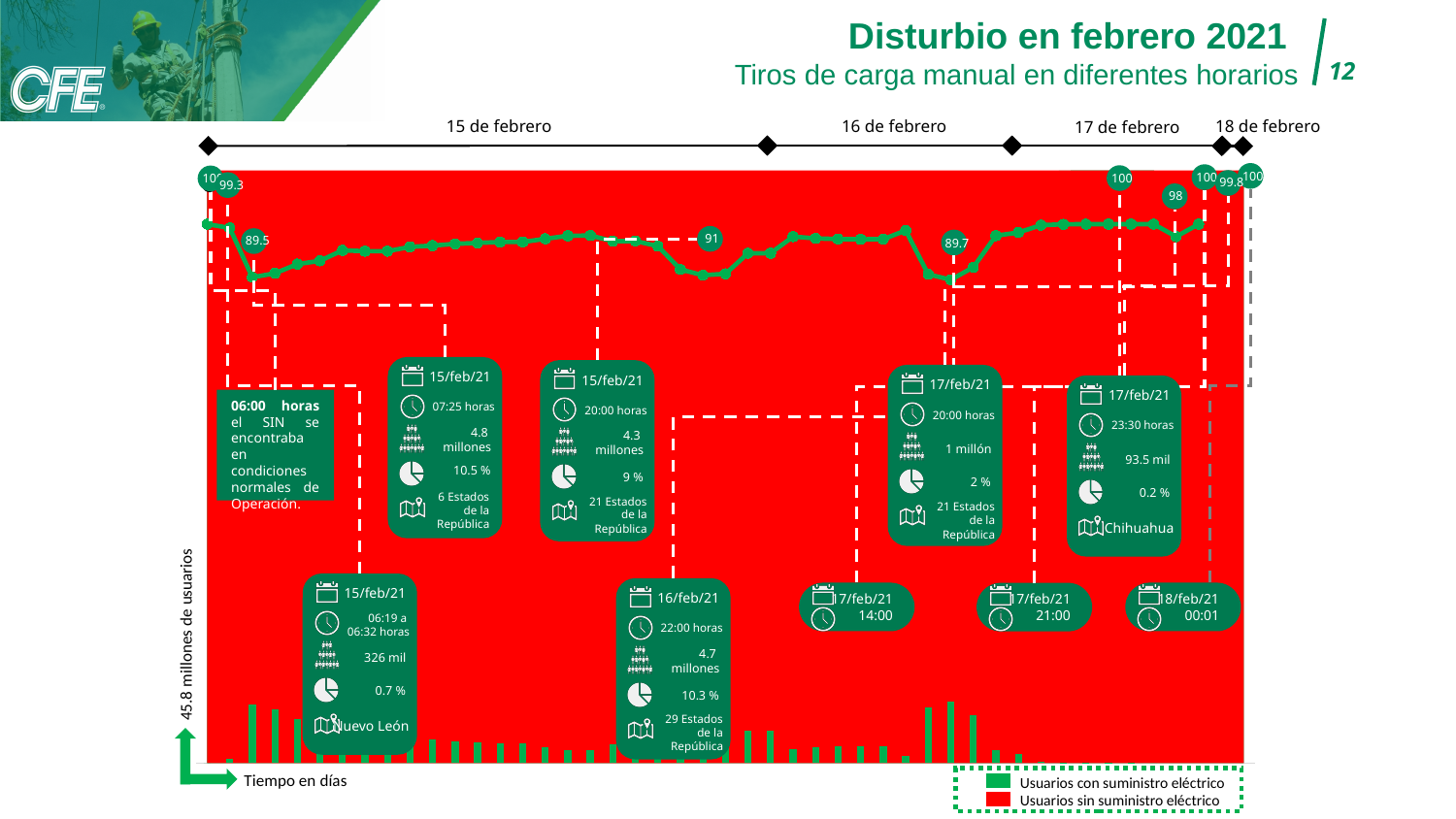
How many dates are marked along the top time axis? 4 How many series does the legend list? 2 What value is labeled on the green line at the dip on 16 de febrero? 89.7 Which labeled value on the green line is larger, 91 or 89.7? 91 What is the difference between the labeled values 91 and 89.5 on the green line? 1.5 Does the green line rise or fall between the first point (100) and the point labeled 89.5? fall What is the title of the chart slide? Disturbio en febrero 2021 What are the two legend entries? Usuarios con suministro eléctrico; Usuarios sin suministro eléctrico What kind of chart is the main plot on the slide? combination chart (line, bars and area) What value is labeled on the green line at the dip on 17 de febrero? 98 What is the highest value labeled on the green line? 100 What is the lowest value labeled on the green line? 89.5